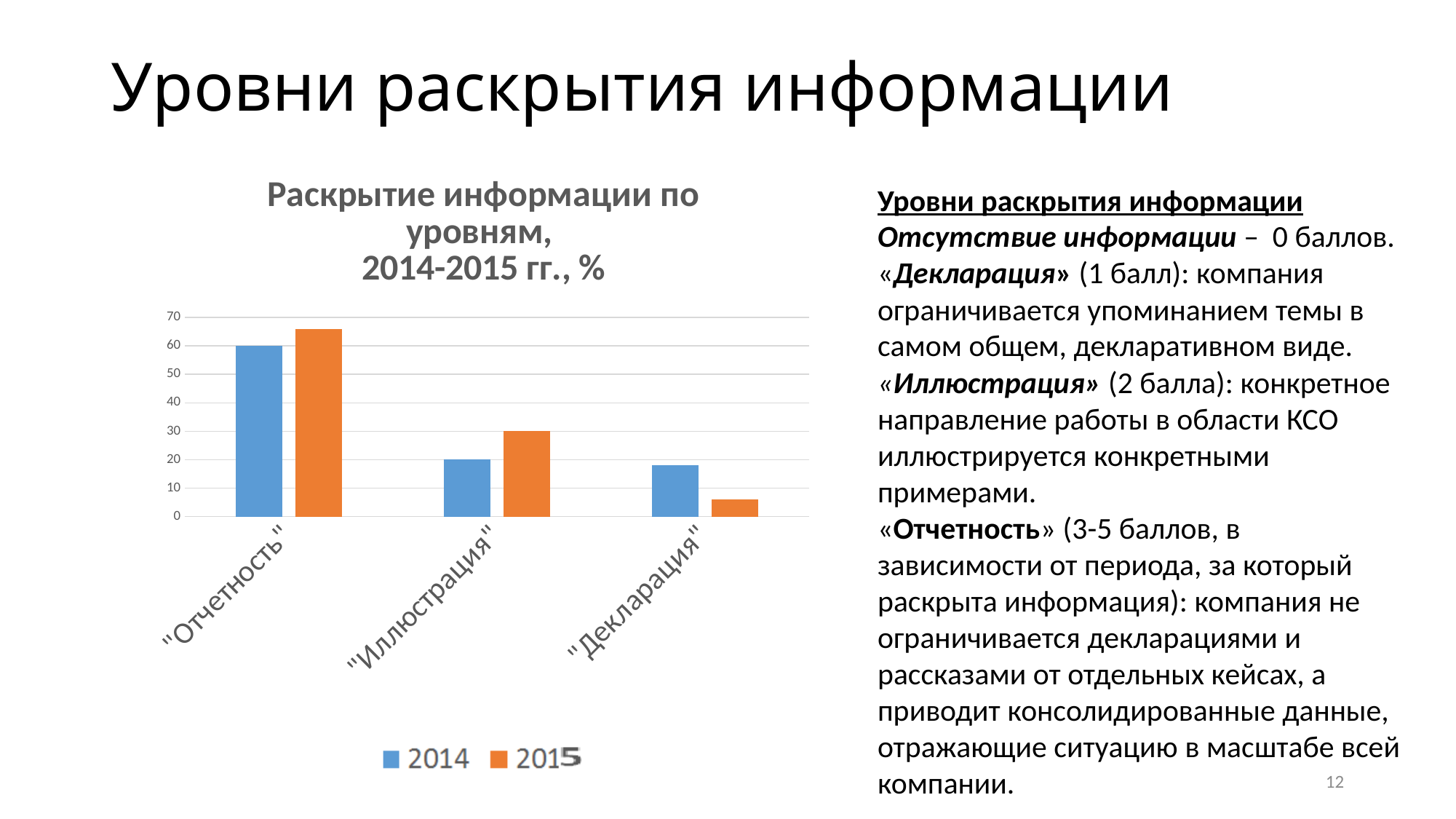
What is the value for "Отчетность" in 2014? 60 What is the value for "Иллюстрация" in 2014? 20 For "Декларация", which year has the larger value, 2014 or 2015? 2014 Is the value for "Декларация" in 2015 greater or less than 10? less What is the value for "Иллюстрация" in 2015? 30 Which category has the lowest value in 2015? "Декларация" Is the value for "Декларация" in 2014 greater or less than 10? greater Is the value for "Отчетность" in 2015 greater or less than 60? greater What kind of chart is shown on the slide? bar chart How many categories are shown on the x axis of the chart? 3 How many series does the chart legend list? 2 Which category has the highest value in 2015? "Отчетность"